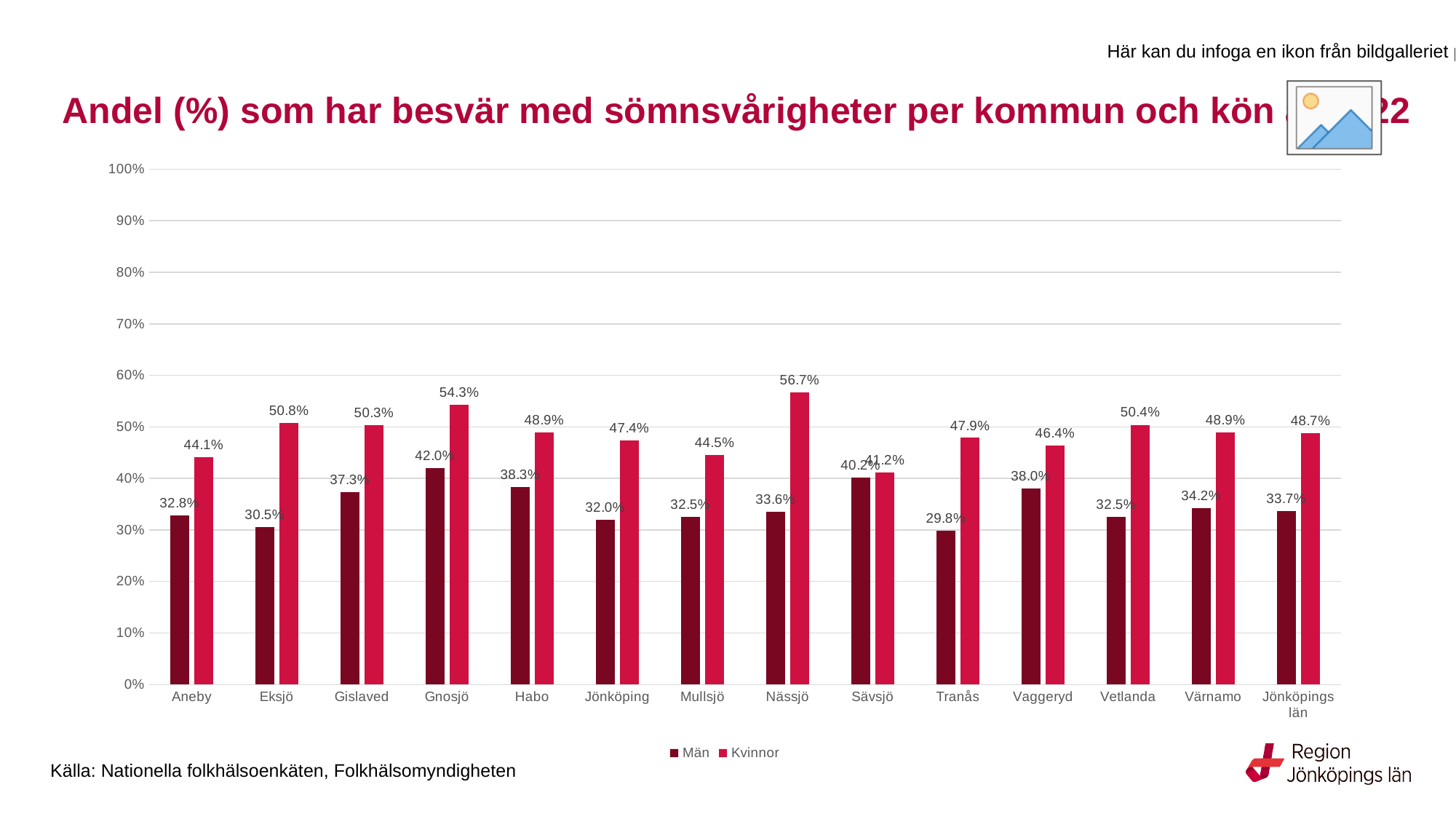
Which category has the lowest value for Män? Tranås Which category has the lowest value for Kvinnor? Sävsjö What is the difference between the Kvinnor and Män values in Sävsjö? 1.0% How many series does the legend list? 2 What is the value for Män in Gnosjö? 42.0% What is the value for Kvinnor in Nässjö? 56.7% Which category has the highest value for Kvinnor? Nässjö Is the value for Kvinnor in Gnosjö greater or less than 50%? greater How many categories are shown on the x axis? 14 What kind of chart is shown on the slide? Bar chart What is the value for Män in Jönköpings län? 33.7% Which is larger: the Män value in Habo or the Män value in Vaggeryd? Habo